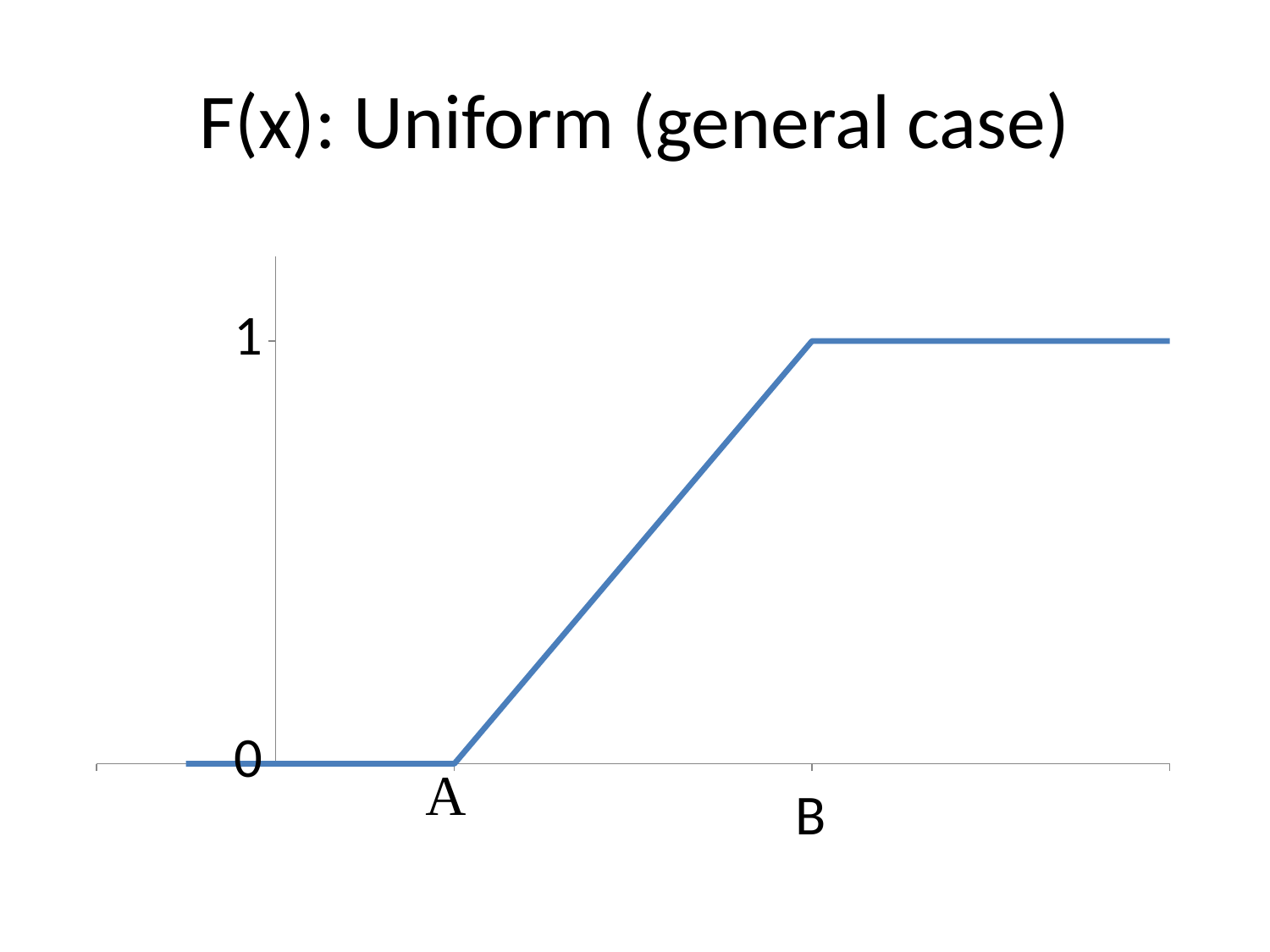
Does the line rise or fall between A and B? rise What is the value of F(x) for x to the right of B? 1 What is the value of F(x) for x to the left of A? 0 Is the value of F(x) halfway between A and B greater or less than 1? less What is the title of the chart? F(x): Uniform (general case) What is the value of F(x) at x = A? 0 What labels are shown on the x axis? A and B Which is larger, the value of F(x) at A or at B? B What is the highest value reached by the line? 1 What kind of chart is shown on the slide? line chart What is the value of F(x) at x = B? 1 What is the difference between the value of F(x) at B and at A? 1